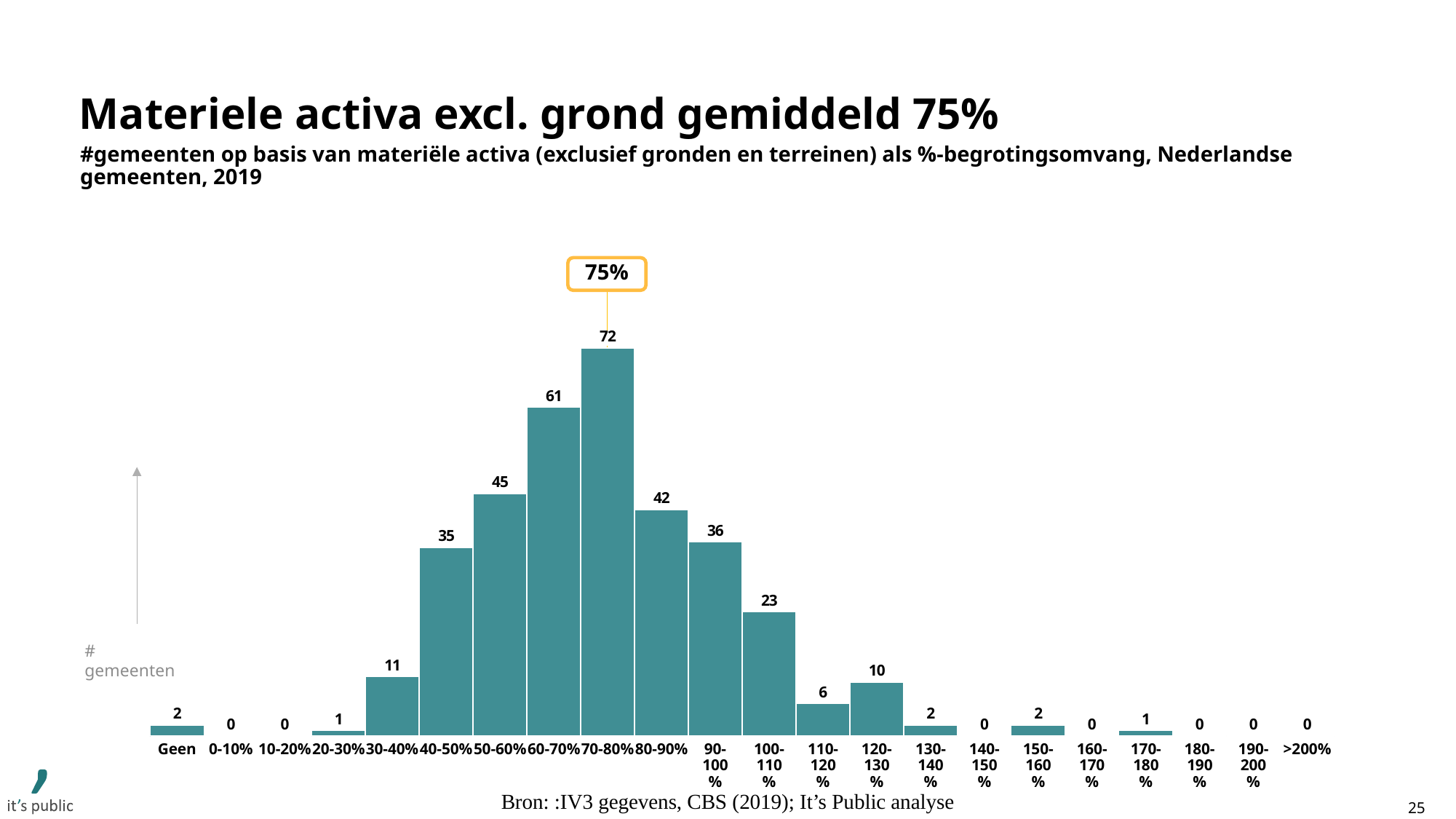
What value is shown in the highlighted box above the tallest bar? 75% How many categories are shown on the x axis? 22 Which category has the highest number of gemeenten? 70-80% Do the values rise or fall from the 70-80% category to the 130-140% category? Fall How many gemeenten are in the 70-80% category? 72 Which is larger, the value for 110-120% or the value for 120-130%? 120-130% How many gemeenten fall in the 'Geen' category? 2 Which is larger, the value for 50-60% or the value for 80-90%? 50-60% What is the difference between the 70-80% and 60-70% categories? 11 What is the difference between the 80-90% and 90-100% categories? 6 What kind of chart is shown on the slide? Bar chart What is the value for the 40-50% category? 35